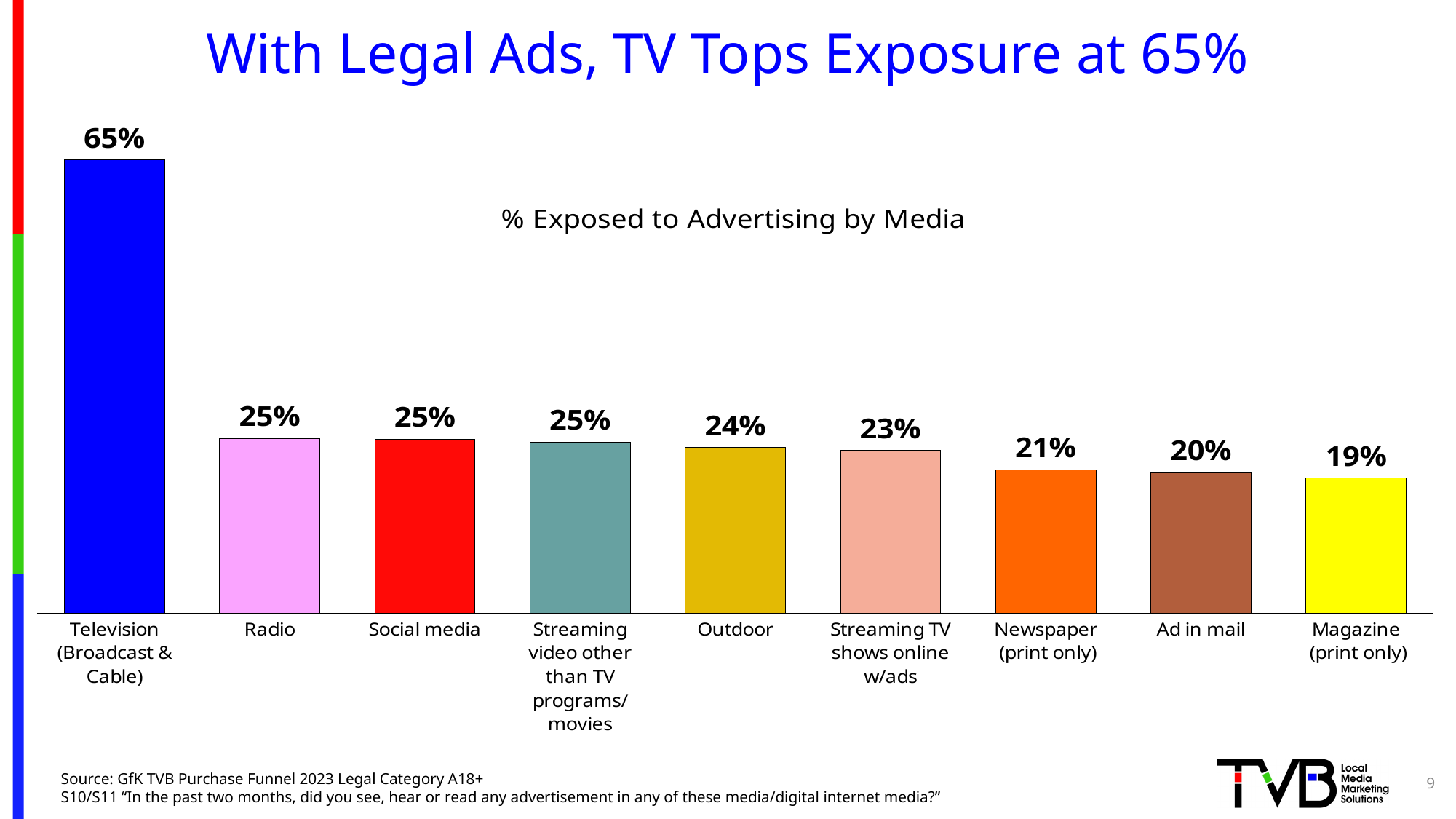
What is the value for Outdoor? 24% What is the difference between the values for Outdoor and Ad in mail? 4 percentage points What is the value for Television (Broadcast & Cable)? 65% Which category has the highest value? Television (Broadcast & Cable) What is the title of the chart? % Exposed to Advertising by Media Which is larger, the value for Newspaper (print only) or the value for Magazine (print only)? Newspaper (print only) What is the difference between the values for Television (Broadcast & Cable) and Radio? 40 percentage points Which category has the lowest value? Magazine (print only) What kind of chart is shown on the slide? Bar chart How many categories are shown in the chart? 9 What is the value for Newspaper (print only)? 21% What is the value for Streaming TV shows online w/ads? 23%